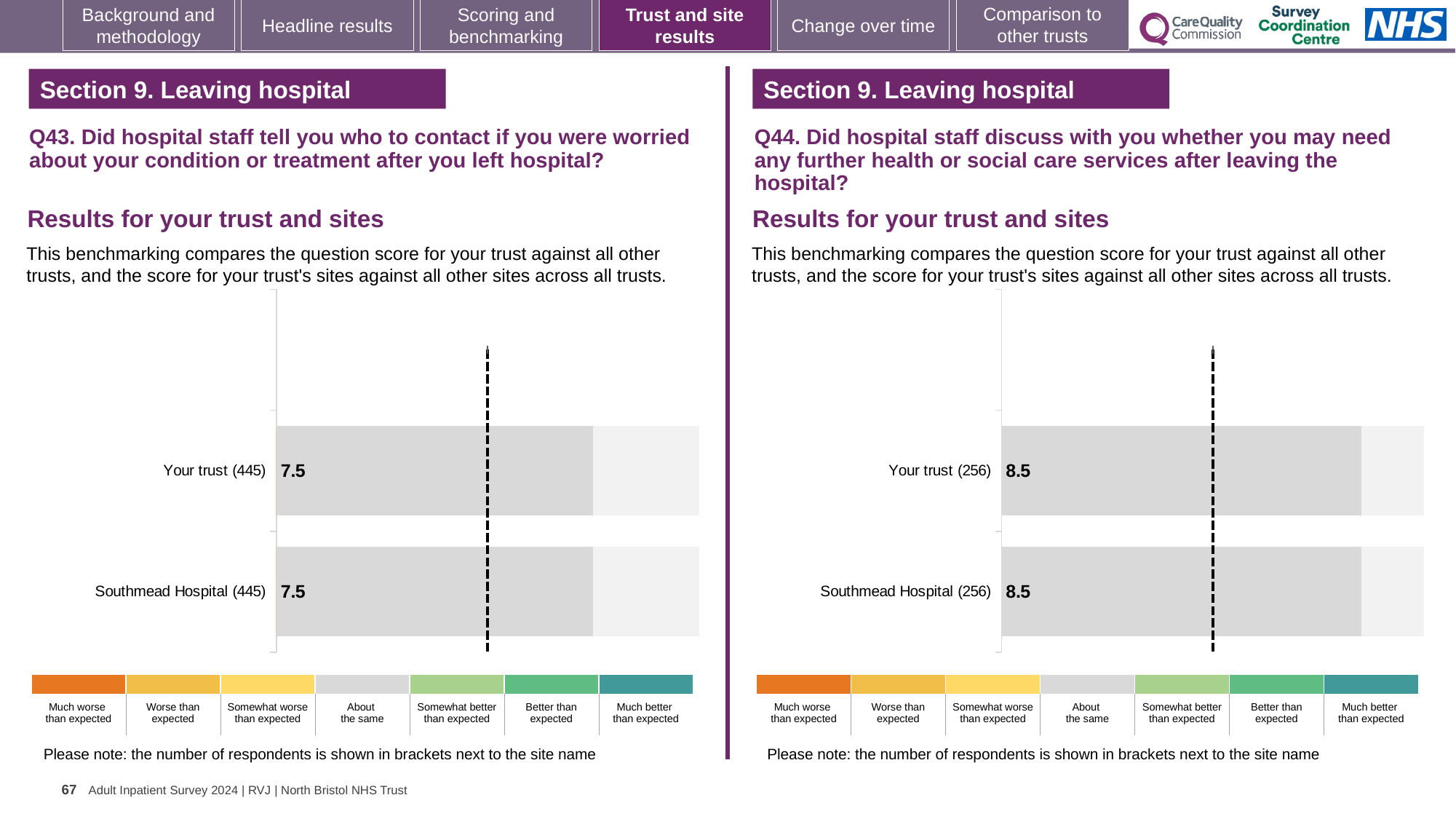
On the Q44 chart (right), what is the score for Southmead Hospital? 8.5 On the Q44 chart (right), what is the score for Your trust? 8.5 On the Q44 chart (right), how many respondents are shown in brackets for Your trust? 256 How many bars are plotted on the Q44 chart (right)? 2 What kind of chart is used on the Q43 chart (left)? Bar chart On the Q43 chart (left), how many respondents are shown in brackets for Southmead Hospital? 445 On the Q44 chart (right), what is the difference between the scores for Your trust and Southmead Hospital? 0.0 On the Q43 chart (left), what is the score for Southmead Hospital? 7.5 Is the score for Your trust on the Q44 chart (right) larger or smaller than the score for Your trust on the Q43 chart (left)? Larger On the Q43 chart (left), what is the difference between the scores for Your trust and Southmead Hospital? 0.0 How many bars are plotted on the Q43 chart (left)? 2 On the Q43 chart (left), what is the score for Your trust? 7.5